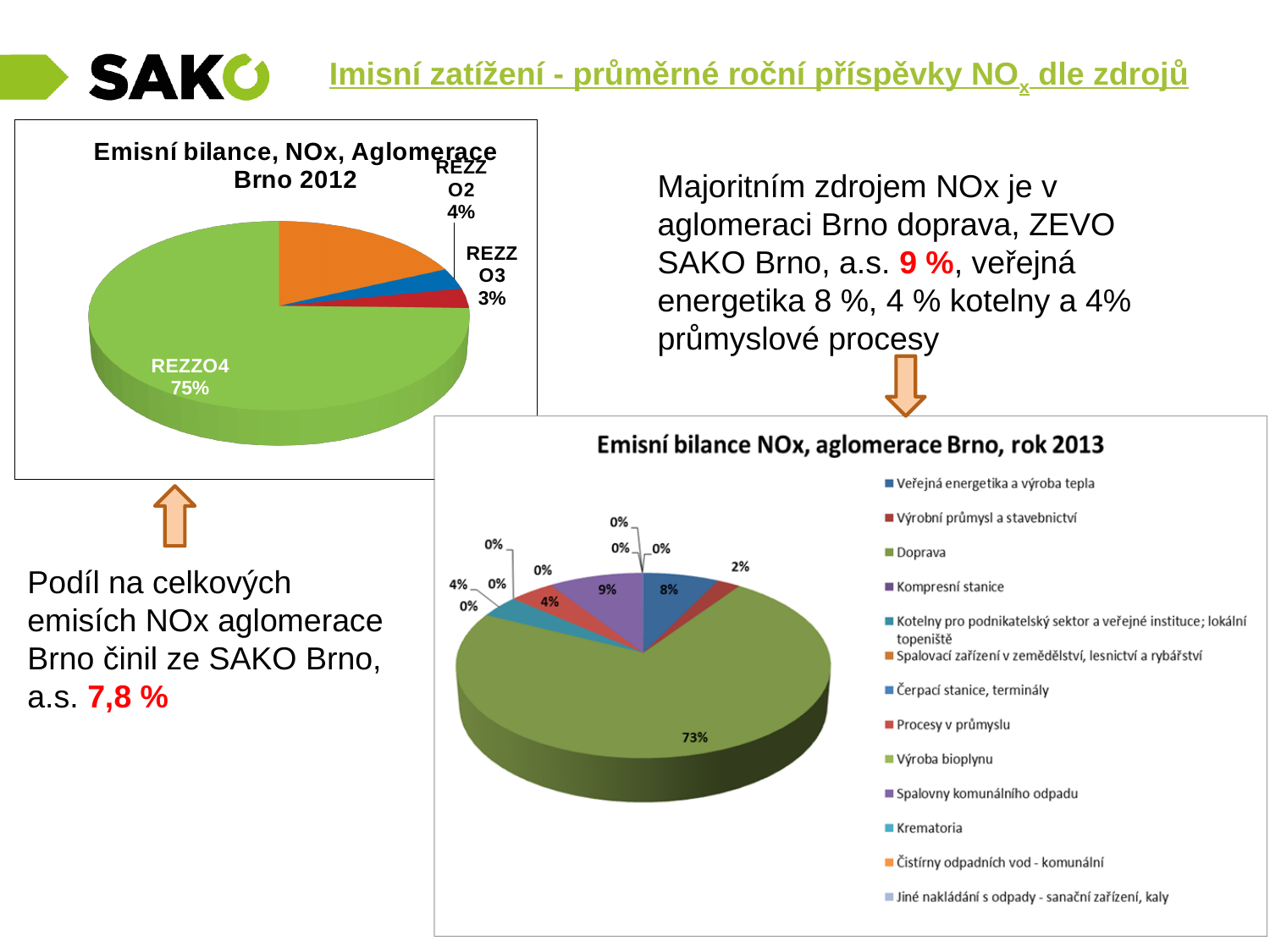
In the pie chart titled 'Emisní bilance, NOx, Aglomerace Brno 2012', what is the value for REZZO2? 4% In the pie chart titled 'Emisní bilance, NOx, Aglomerace Brno 2012', which category has the largest share? REZZO4 In the pie chart titled 'Emisní bilance, NOx, Aglomerace Brno 2012', what is the value for REZZO3? 3% In the pie chart titled 'Emisní bilance NOx, aglomerace Brno, rok 2013', which category has the largest share? Doprava In the pie chart titled 'Emisní bilance, NOx, Aglomerace Brno 2012', what is the value for REZZO4? 75% In the pie chart titled 'Emisní bilance NOx, aglomerace Brno, rok 2013', what is the largest percentage shown on a slice? 73% What kind of chart is the one titled 'Emisní bilance NOx, aglomerace Brno, rok 2013'? Pie chart How many entries does the legend of the chart titled 'Emisní bilance NOx, aglomerace Brno, rok 2013' list? 13 What is the title of the pie chart in the lower right of the slide? Emisní bilance NOx, aglomerace Brno, rok 2013 In the pie chart titled 'Emisní bilance, NOx, Aglomerace Brno 2012', which is larger, REZZO2 or REZZO3? REZZO2 In the pie chart titled 'Emisní bilance, NOx, Aglomerace Brno 2012', what is the difference between the REZZO2 and REZZO3 shares? 1 percentage point What kind of chart is the one titled 'Emisní bilance, NOx, Aglomerace Brno 2012'? Pie chart